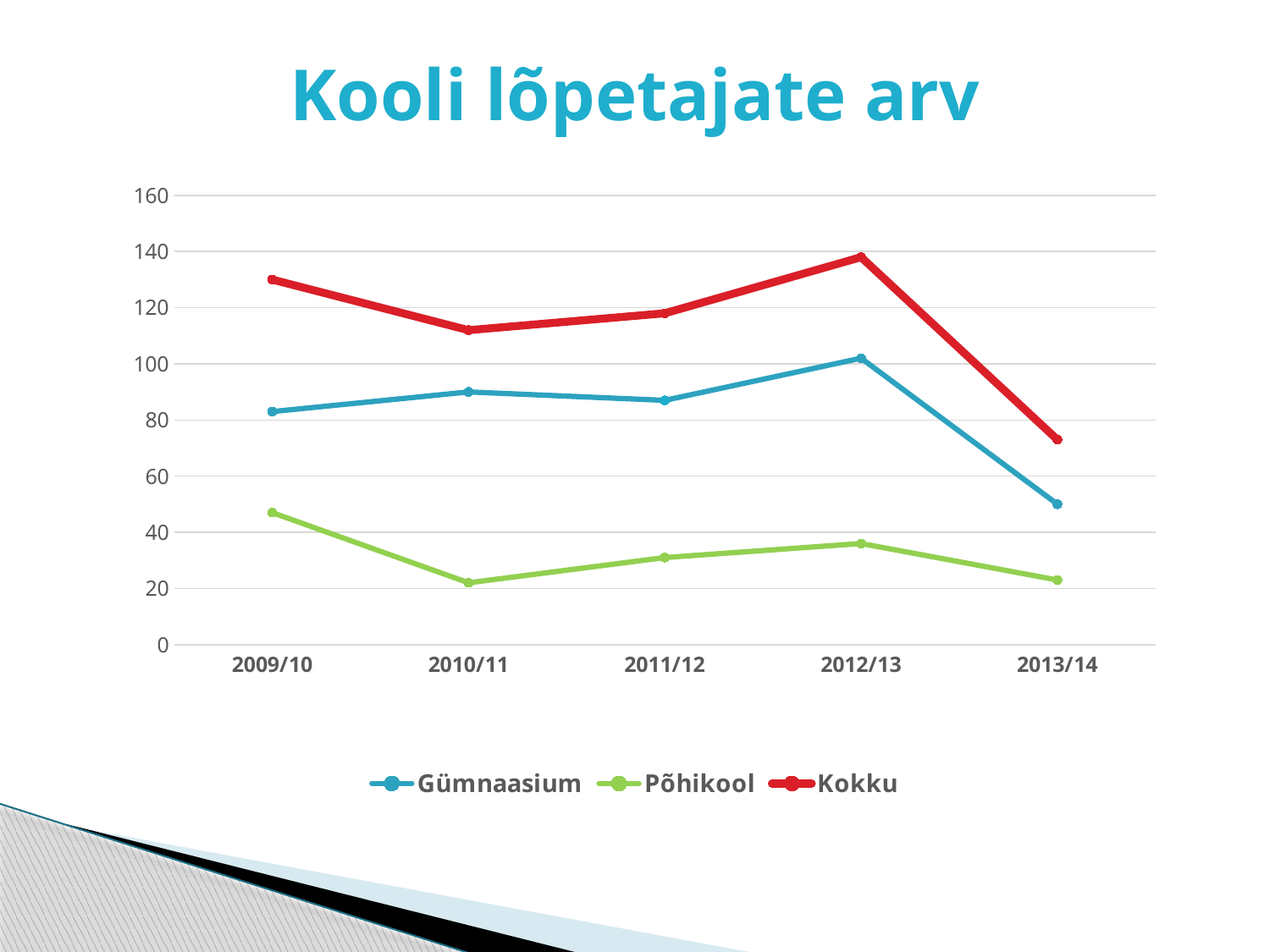
Does the Kokku series rise or fall from 2012/13 to 2013/14? fall How many series does the legend list? 3 What is the title of the chart? Kooli lõpetajate arv Is the Gümnaasium value for 2013/14 greater or less than 60? less In which school year is the Kokku series at its highest? 2012/13 How many school years are shown on the x axis? 5 What kind of chart is shown on the slide? line chart In which school year is the Põhikool series at its highest? 2009/10 Which series is drawn in red? Kokku Is the Kokku value for 2012/13 greater or less than 120? greater In which school year is the Gümnaasium series at its lowest? 2013/14 Is the Põhikool value for 2010/11 greater or less than 40? less